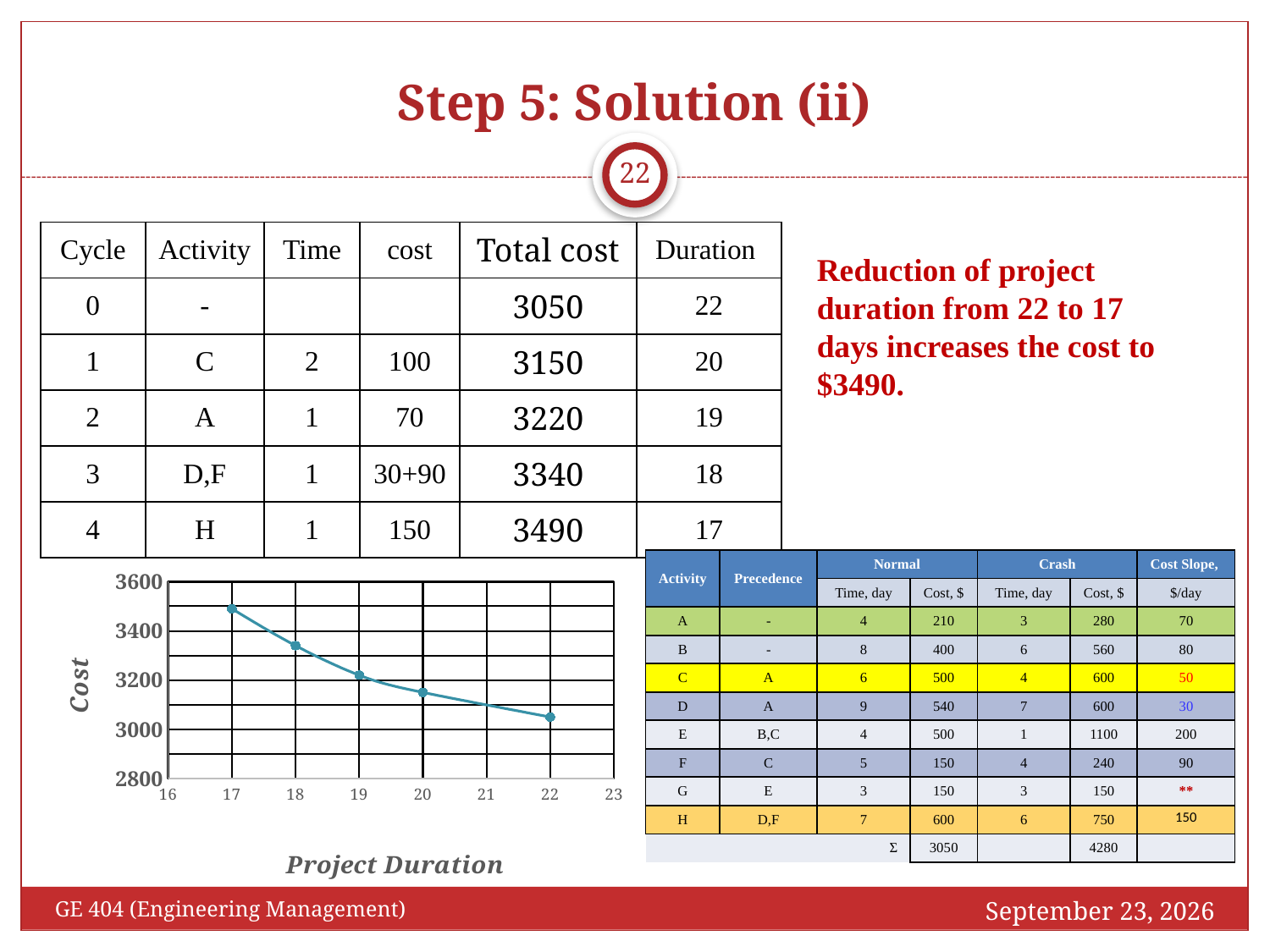
On the Cost vs Project Duration chart, which has the larger cost: a duration of 18 or a duration of 20? 18 What is the label of the vertical axis on the chart? Cost How many data points are plotted on the Cost vs Project Duration chart? 5 On the Cost vs Project Duration chart, is the cost at a duration of 17 greater or less than 3400? greater On the Cost vs Project Duration chart, does the cost rise or fall as project duration increases along the x axis? fall On the Cost vs Project Duration chart, is the cost at a duration of 20 greater or less than 3000? greater On the Cost vs Project Duration chart, is the cost at a duration of 22 greater or less than 3200? less What is the label of the horizontal axis on the chart? Project Duration On the Cost vs Project Duration chart, at which project duration is the plotted cost lowest? 22 On the Cost vs Project Duration chart, at which project duration is the plotted cost highest? 17 What kind of chart is shown at the bottom left of the slide? line chart